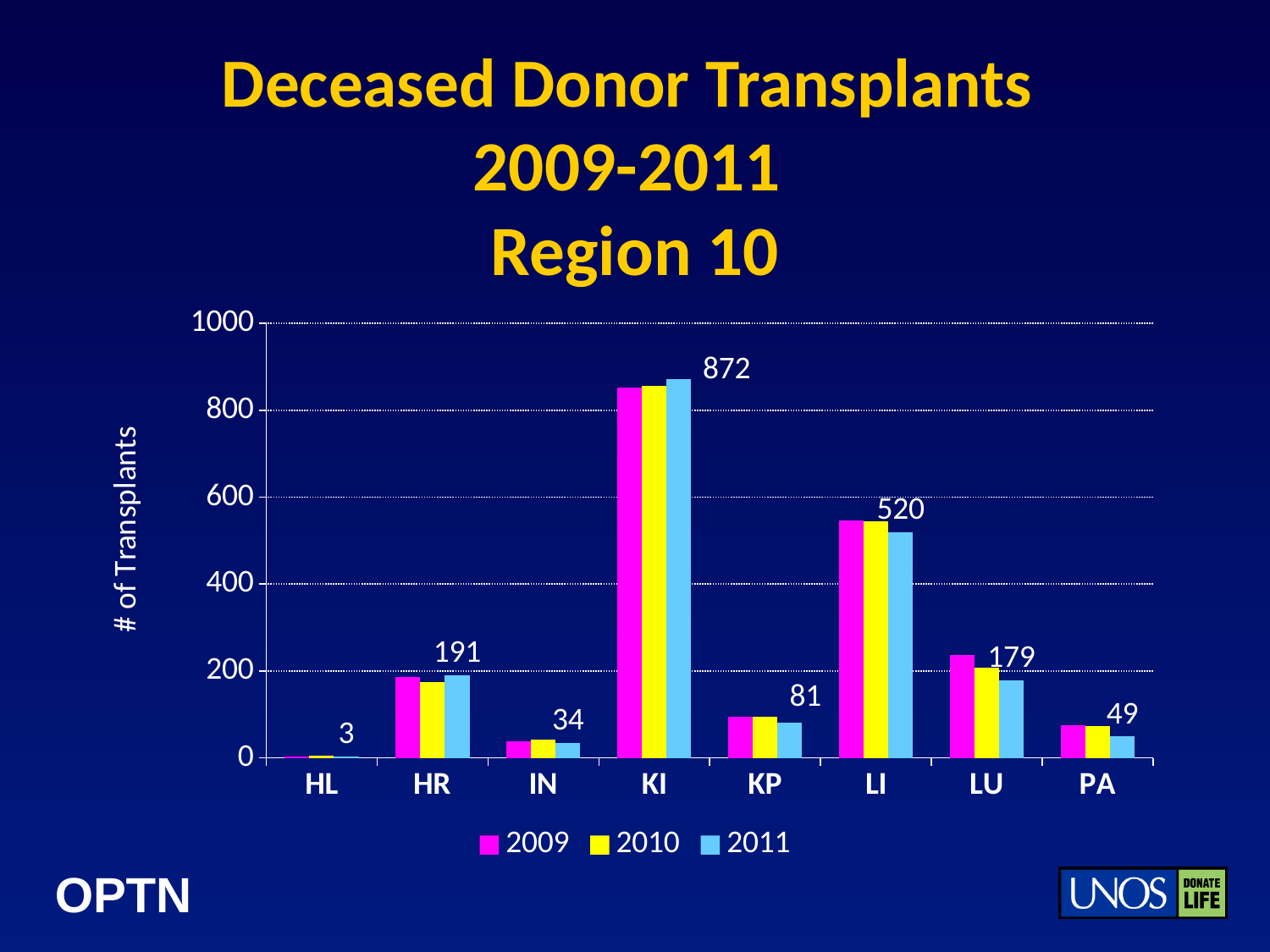
What kind of chart is shown on the slide? Bar chart What is the value for PA in 2011? 49 Is the value for LI in 2009 greater or less than 400? greater What is the value for KI in 2011? 872 What is the value for LI in 2011? 520 Which organ category has the highest number of transplants in 2011? KI Which is larger in 2011, the value for LU or the value for KP? LU Which organ category has the lowest number of transplants in 2011? HL How many series does the legend list? 3 How many organ categories are shown on the x axis? 8 What is the value for HR in 2011? 191 What is the difference between the 2011 values for KI and LI? 352